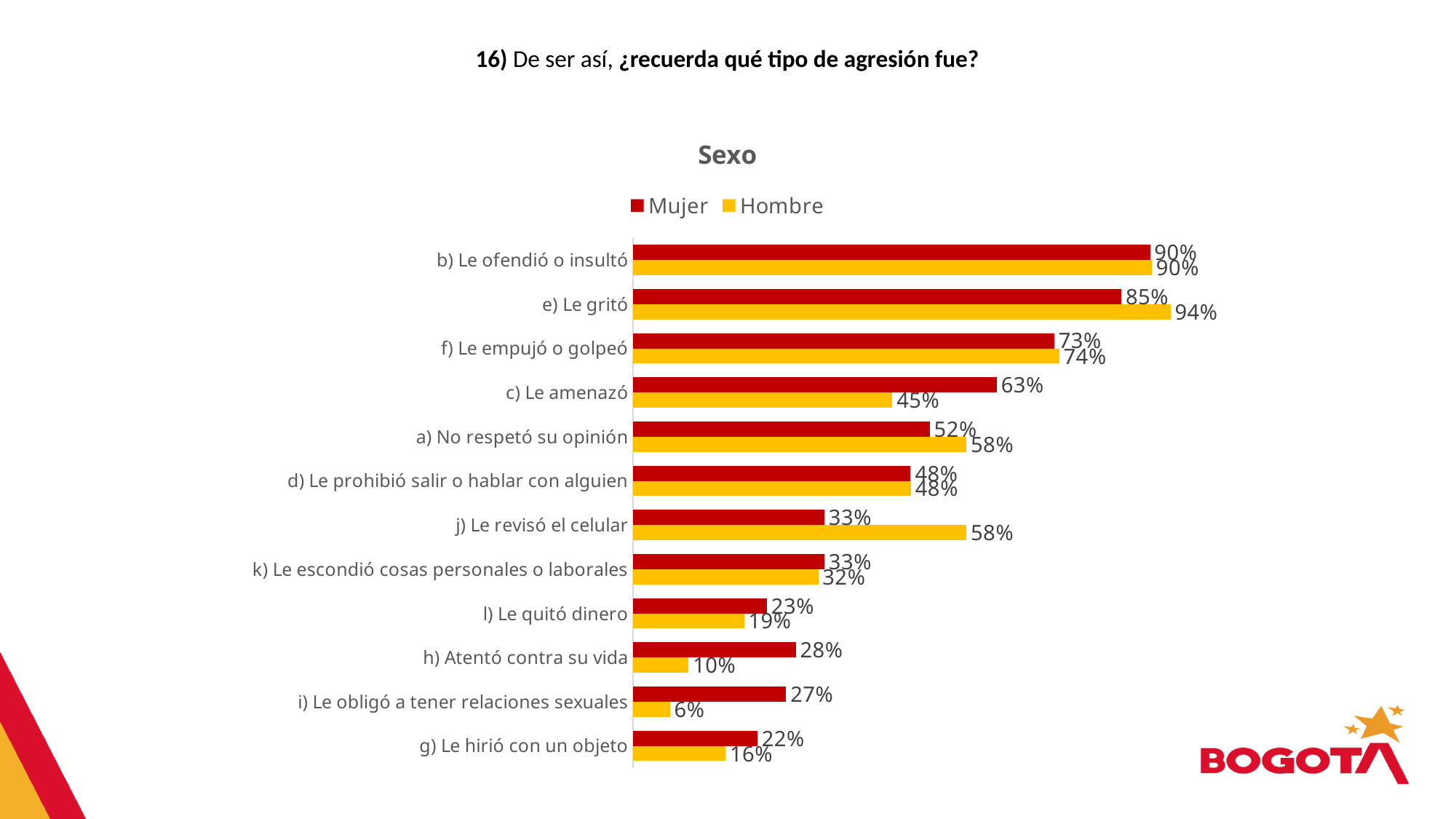
Which category has the lowest Hombre value? i) Le obligó a tener relaciones sexuales What is the difference between the Mujer and Hombre values for "h) Atentó contra su vida"? 18% Which category has the lowest Mujer value? g) Le hirió con un objeto What is the Hombre value for "i) Le obligó a tener relaciones sexuales"? 6% Which category has the highest Hombre value? e) Le gritó What is the Mujer value for "e) Le gritó"? 85% What is the difference between the Hombre and Mujer values for "j) Le revisó el celular"? 25% How many categories are shown in the chart? 12 How many series does the legend list? 2 What is the Hombre value for "c) Le amenazó"? 45% What type of chart is shown on the slide? Bar chart For "a) No respetó su opinión", which is larger, the Mujer or the Hombre value? Hombre